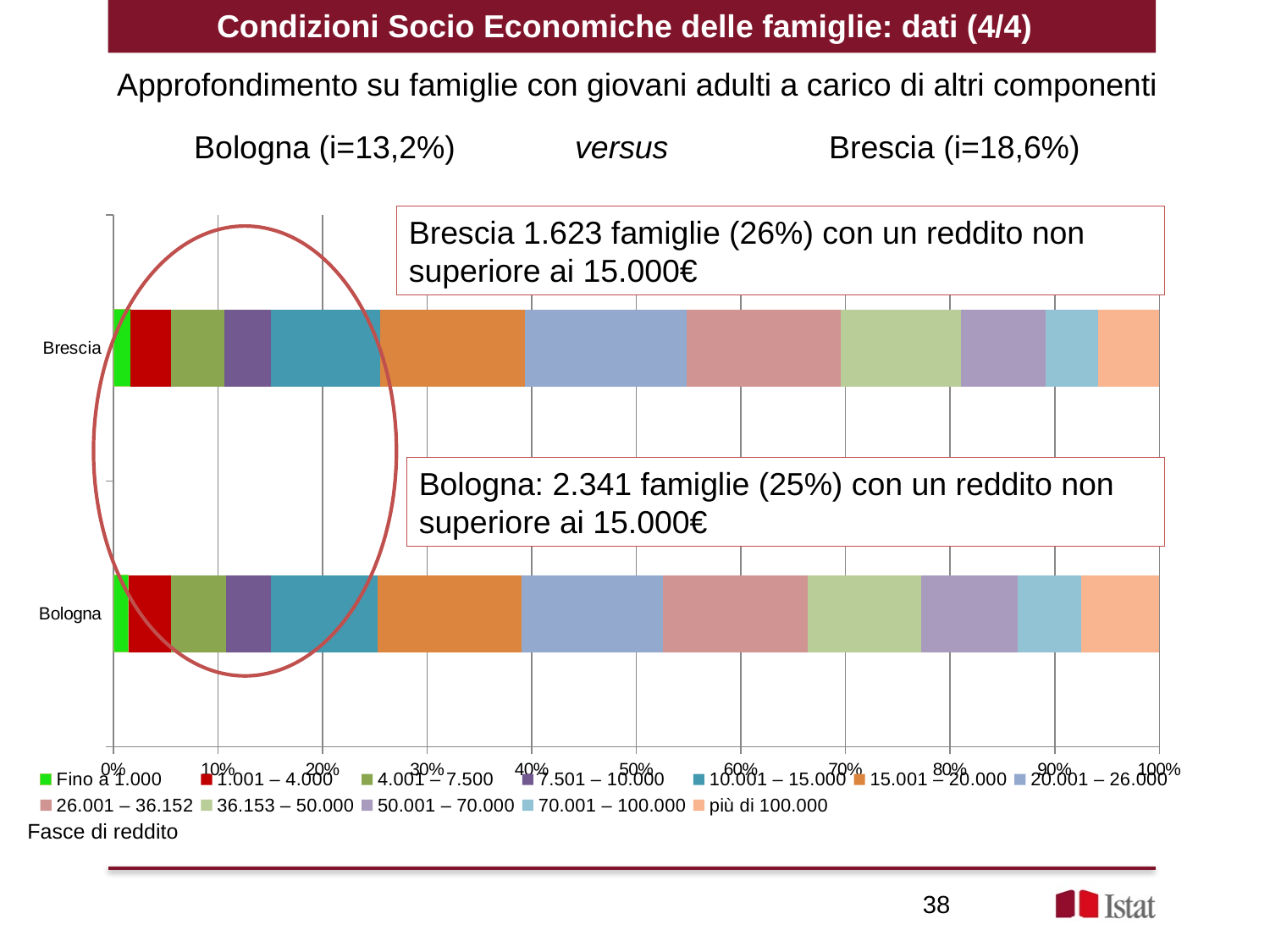
Is the cumulative share of Brescia families with income up to 15.000€ (end of the 10.001 – 15.000 segment) greater or less than 30%? less How many income bands (series) does the chart legend list? 12 What is the first income band listed in the chart legend? Fino a 1.000 Which city has the larger share of families with income not above 15.000€, Brescia or Bologna? Brescia What kind of chart is shown on the slide? Stacked bar chart According to the annotation on the chart, how many Bologna families have an income not above 15.000€? 2.341 What is the difference between the number of Bologna families (2.341) and Brescia families (1.623) with income not above 15.000€? 718 What label is given below the legend to describe the series? Fasce di reddito According to the annotation on the chart, what percentage of Brescia families have an income not above 15.000€? 26% Which income band is the narrowest segment in the Brescia bar? Fino a 1.000 How many cities (categories) are plotted in the chart? 2 Is the cumulative share of Bologna families with income up to 15.000€ (end of the 10.001 – 15.000 segment) greater or less than 20%? greater